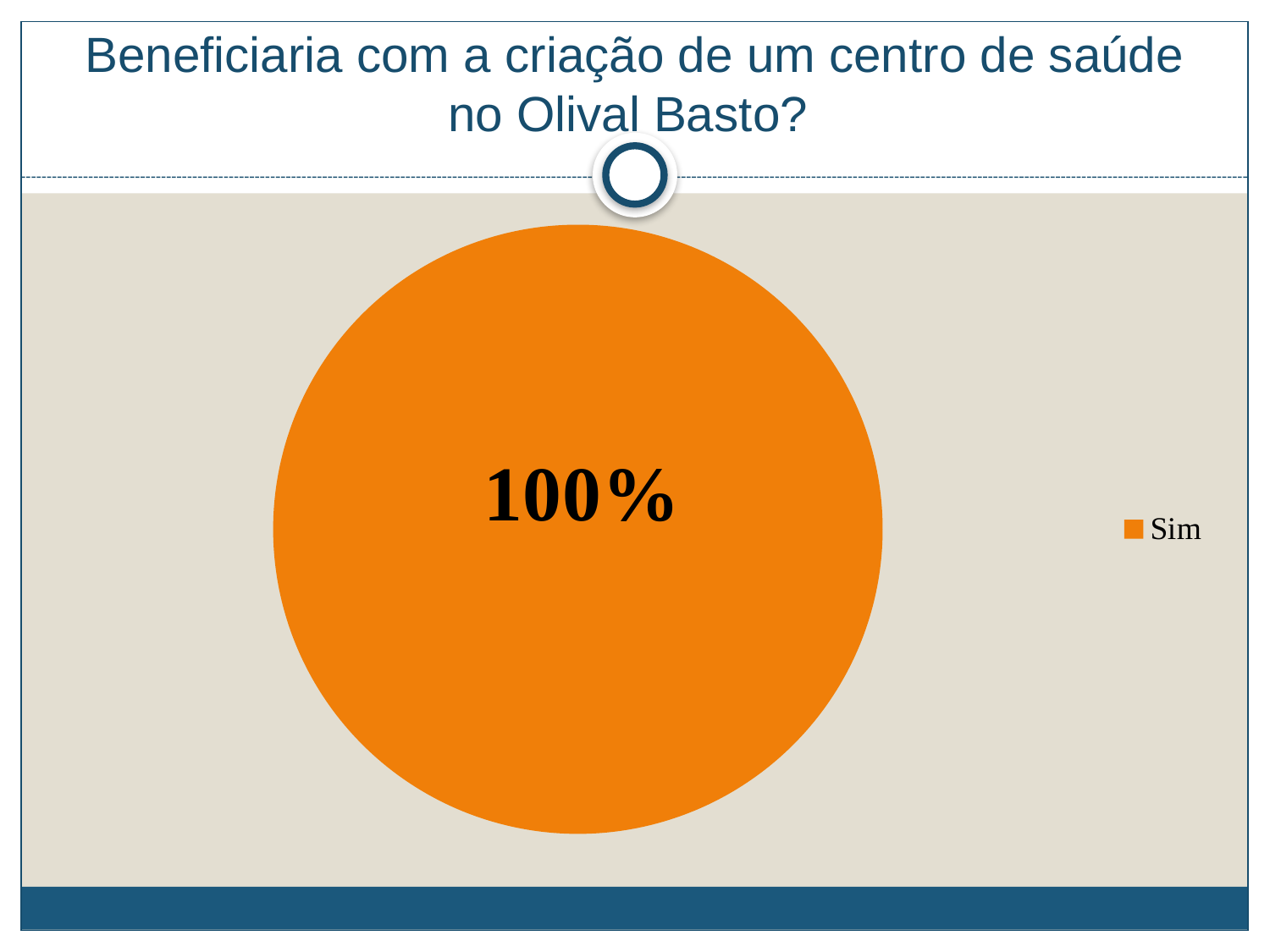
What is the value shown for "Sim" in the pie chart? 100% What share of the pie does the "Sim" slice represent? 100% How many slices does the pie chart have? 1 Which category has the largest share of the pie chart? Sim How many categories does the legend of the pie chart list? 1 What is the only legend entry in the pie chart? Sim What colour is the "Sim" slice in the pie chart? orange What kind of chart is shown on the slide? pie chart